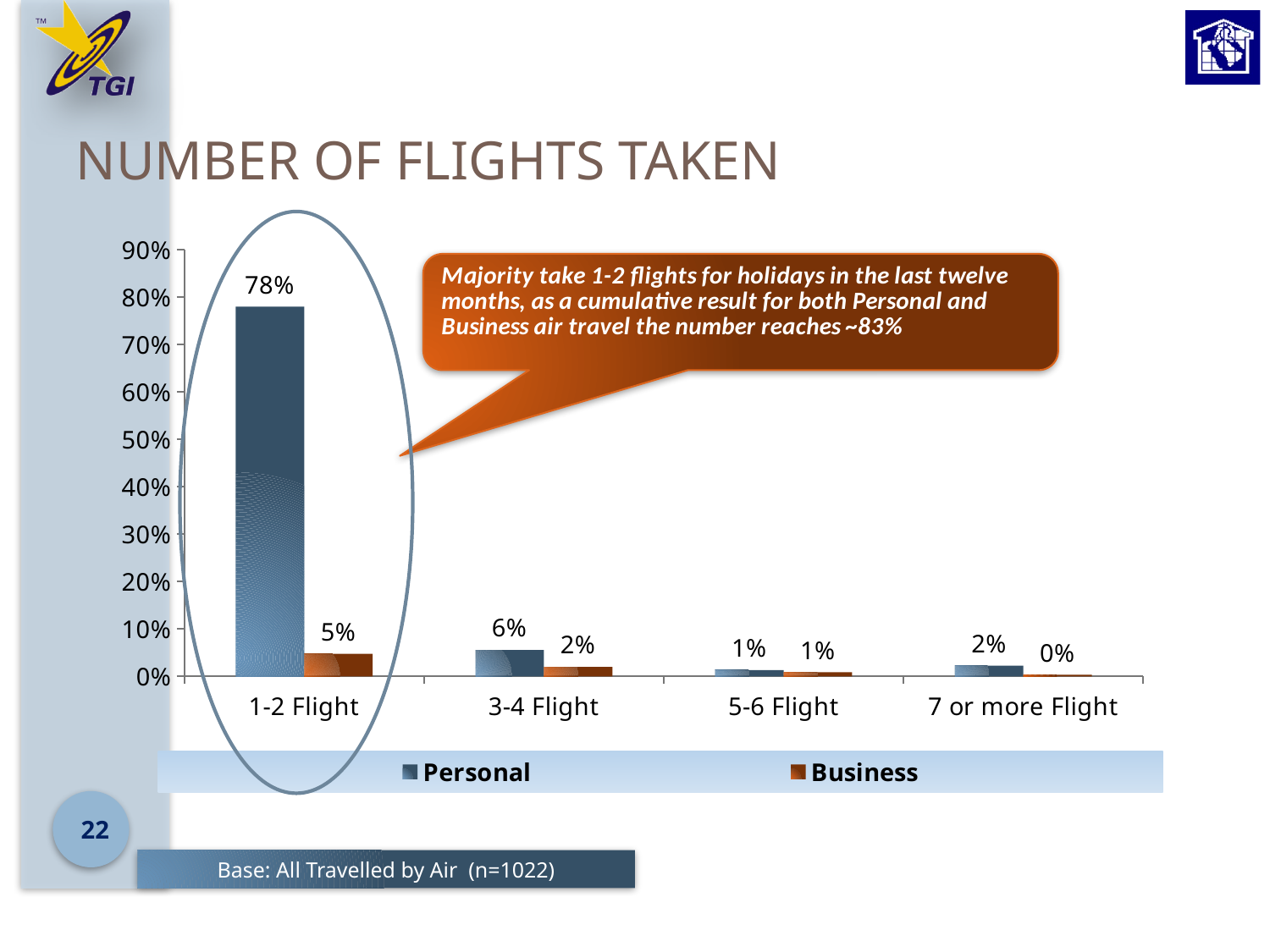
How many series does the legend list? 2 Is the Personal value for 1-2 Flight greater or less than 70%? greater Which category has the highest Personal value? 1-2 Flight What is the Personal value for 1-2 Flight? 78% What is the Business value for 3-4 Flight? 2% Which category has the lowest Business value? 7 or more Flight What kind of chart is shown on the slide? bar chart What is the Business value for 7 or more Flight? 0% How many categories are shown on the x axis? 4 What is the difference between the Personal and Business values for 1-2 Flight? 73% Which is larger for 3-4 Flight, the Personal value or the Business value? Personal What is the title of the slide? NUMBER OF FLIGHTS TAKEN